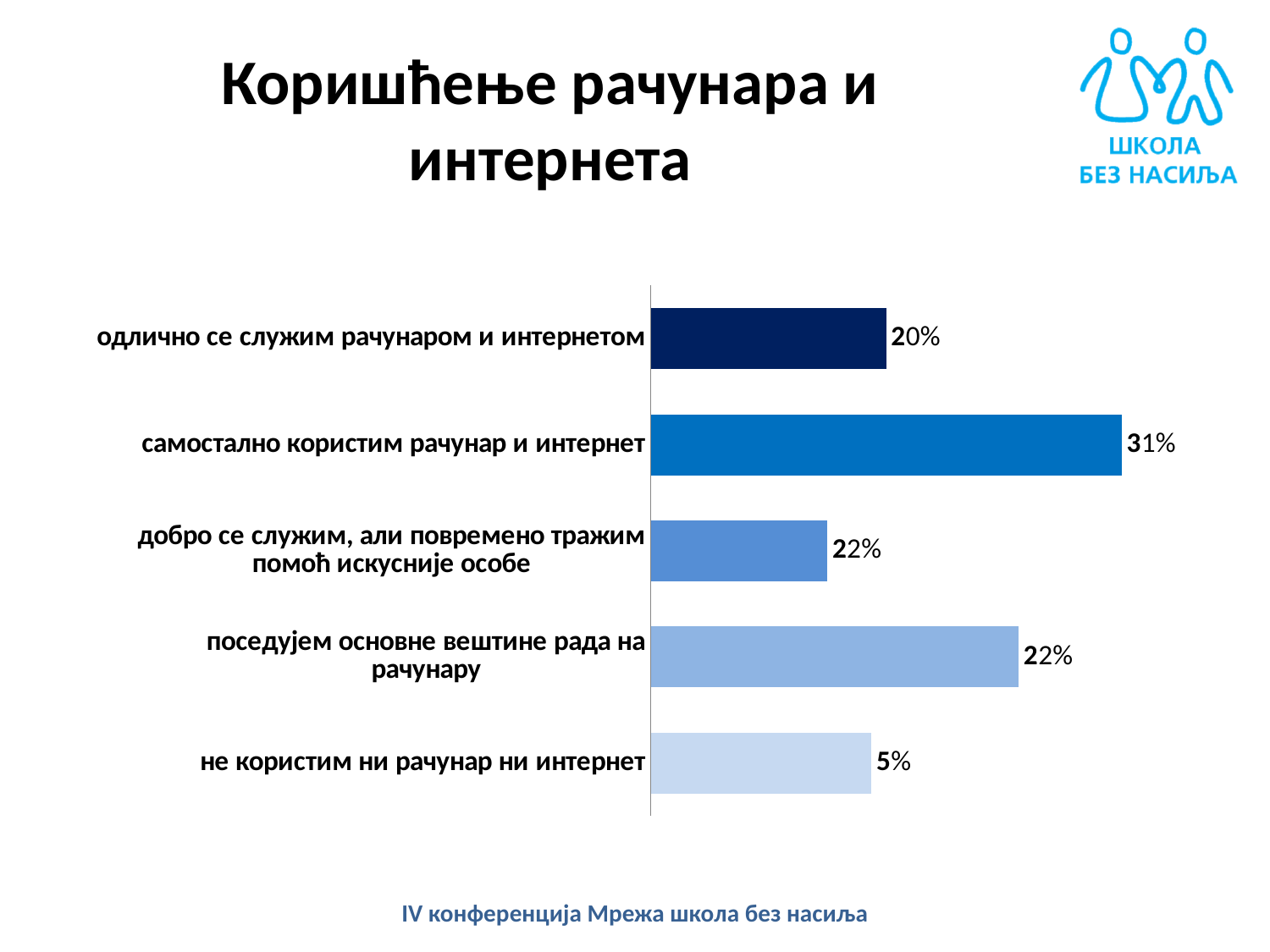
What is the difference between the values for "одлично се служим рачунаром и интернетом" and "не користим ни рачунар ни интернет"? 15% How many categories are shown in the chart? 5 What percentage is shown for "не користим ни рачунар ни интернет"? 5% Which category has the highest value? самостално користим рачунар и интернет What type of chart is shown on the slide? bar chart What percentage of respondents said "одлично се служим рачунаром и интернетом"? 20% What is the difference between the values for "самостално користим рачунар и интернет" and "одлично се служим рачунаром и интернетом"? 11% Which is larger: the value for "самостално користим рачунар и интернет" or the value for "поседујем основне вештине рада на рачунару"? самостално користим рачунар и интернет What value is labelled on the bar for "добро се служим, али повремено тражим помоћ искусније особе"? 22% What is the title of the slide containing the chart? Коришћење рачунара и интернета Which category has the lowest value? не користим ни рачунар ни интернет What is the value shown for "самостално користим рачунар и интернет"? 31%